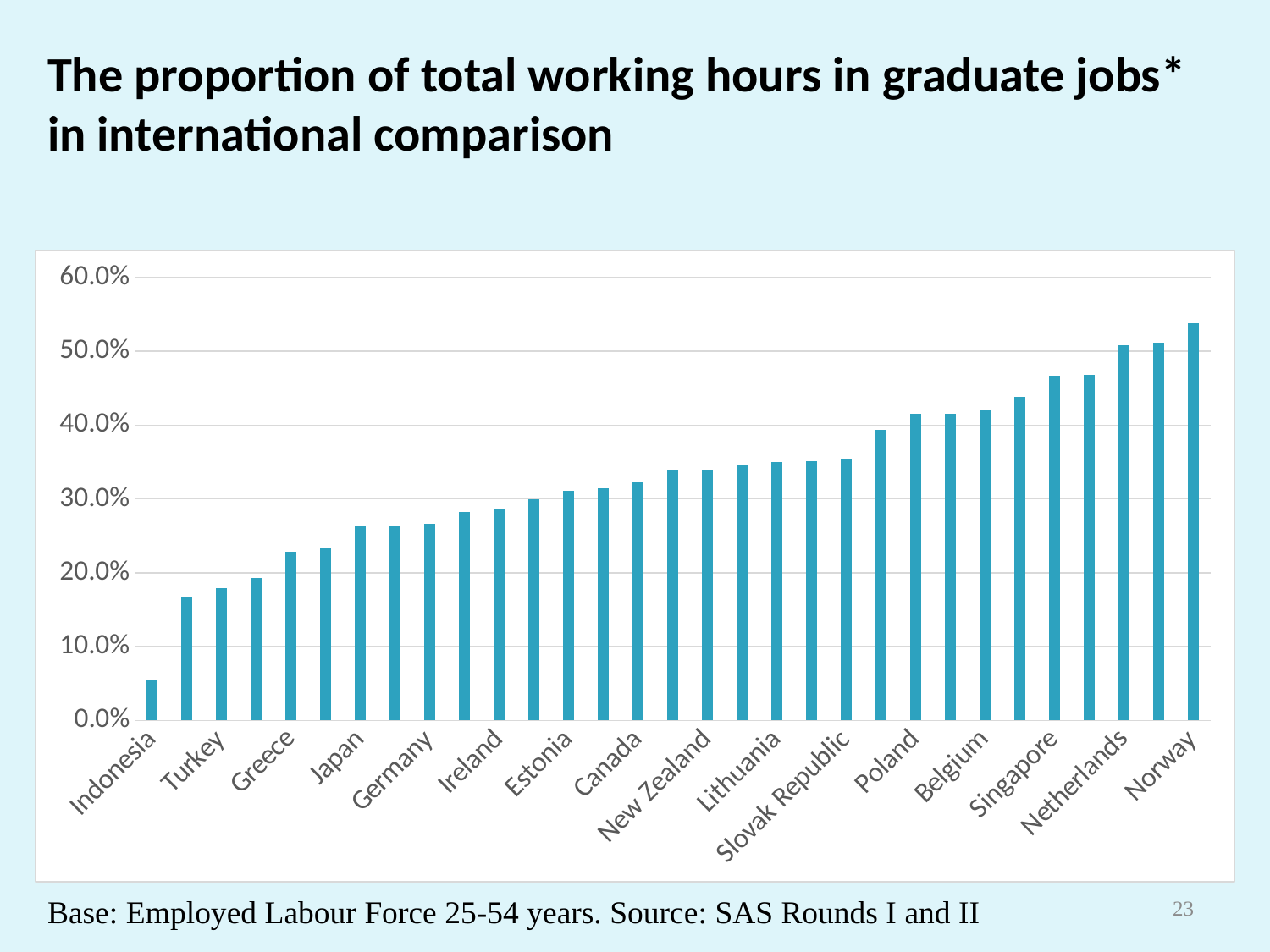
Is the value for Indonesia greater or less than 10.0%? less What kind of chart is shown on the slide? bar chart Is the value for Canada greater or less than 30.0%? greater Is the value for Norway greater or less than 50.0%? greater How many bars are plotted in the chart? 31 What is the title of the slide? The proportion of total working hours in graduate jobs* in international comparison Which country has the highest proportion of total working hours in graduate jobs? Norway Which country has the lowest proportion of total working hours in graduate jobs? Indonesia Which has a larger value, Japan or Belgium? Belgium Do the values rise or fall moving from left to right along the x axis? rise